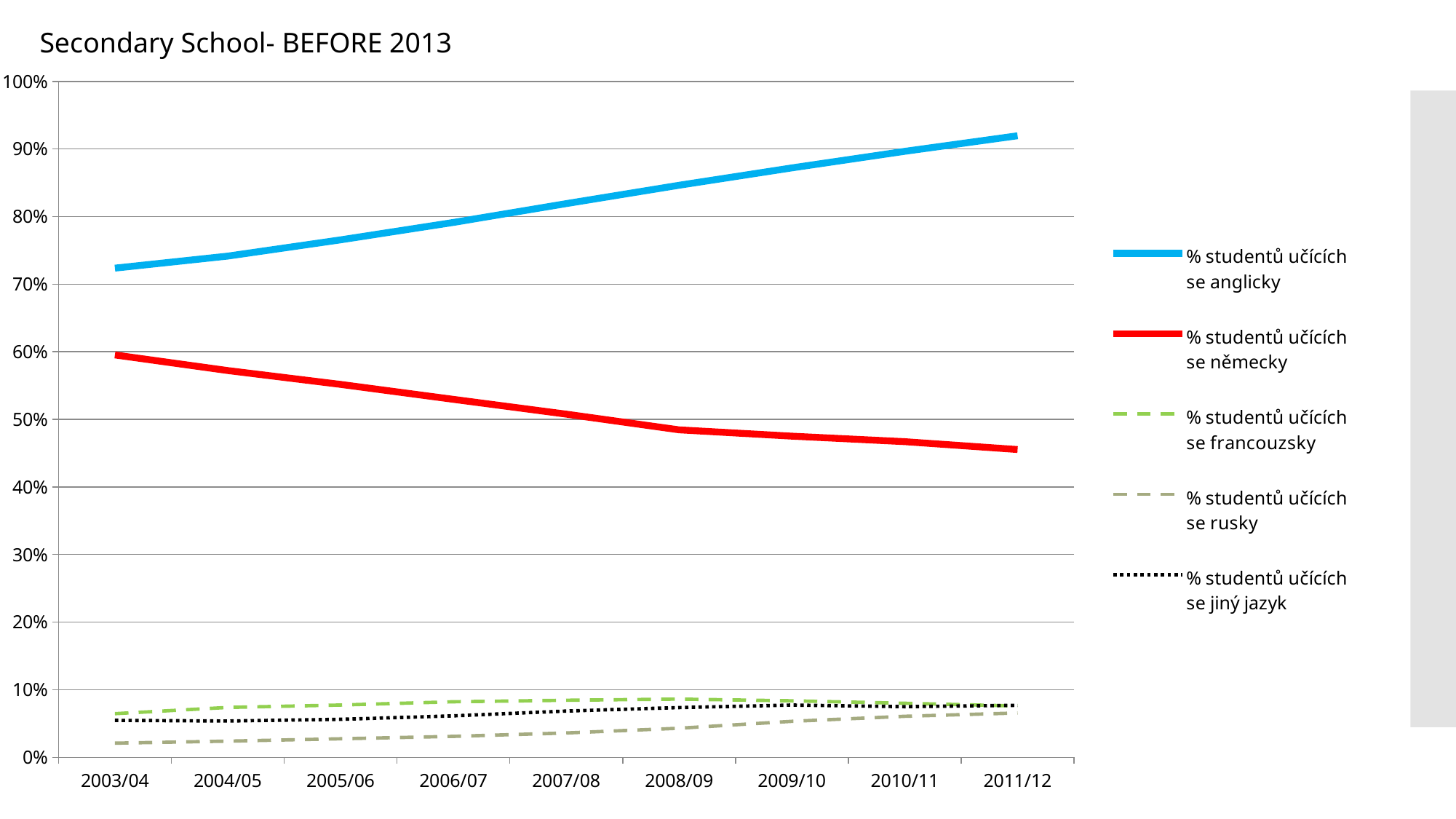
Which series has the lowest value in 2003/04? % studentů učících se rusky In 2003/04, which is larger: the value for '% studentů učících se anglicky' or '% studentů učících se německy'? % studentů učících se anglicky Is the value for '% studentů učících se německy' in 2011/12 greater or less than 50%? less Does the value for '% studentů učících se německy' rise or fall from 2003/04 to 2011/12? fall Which series has the highest value in 2011/12? % studentů učících se anglicky What is the title of the chart? Secondary School- BEFORE 2013 What kind of chart is shown on the slide? line chart How many series does the legend list? 5 Does the value for '% studentů učících se anglicky' rise or fall from 2003/04 to 2011/12? rise How many school years are shown on the x axis? 9 Is the value for '% studentů učících se anglicky' in 2011/12 greater or less than 90%? greater Is the value for '% studentů učících se anglicky' in 2003/04 greater or less than 70%? greater